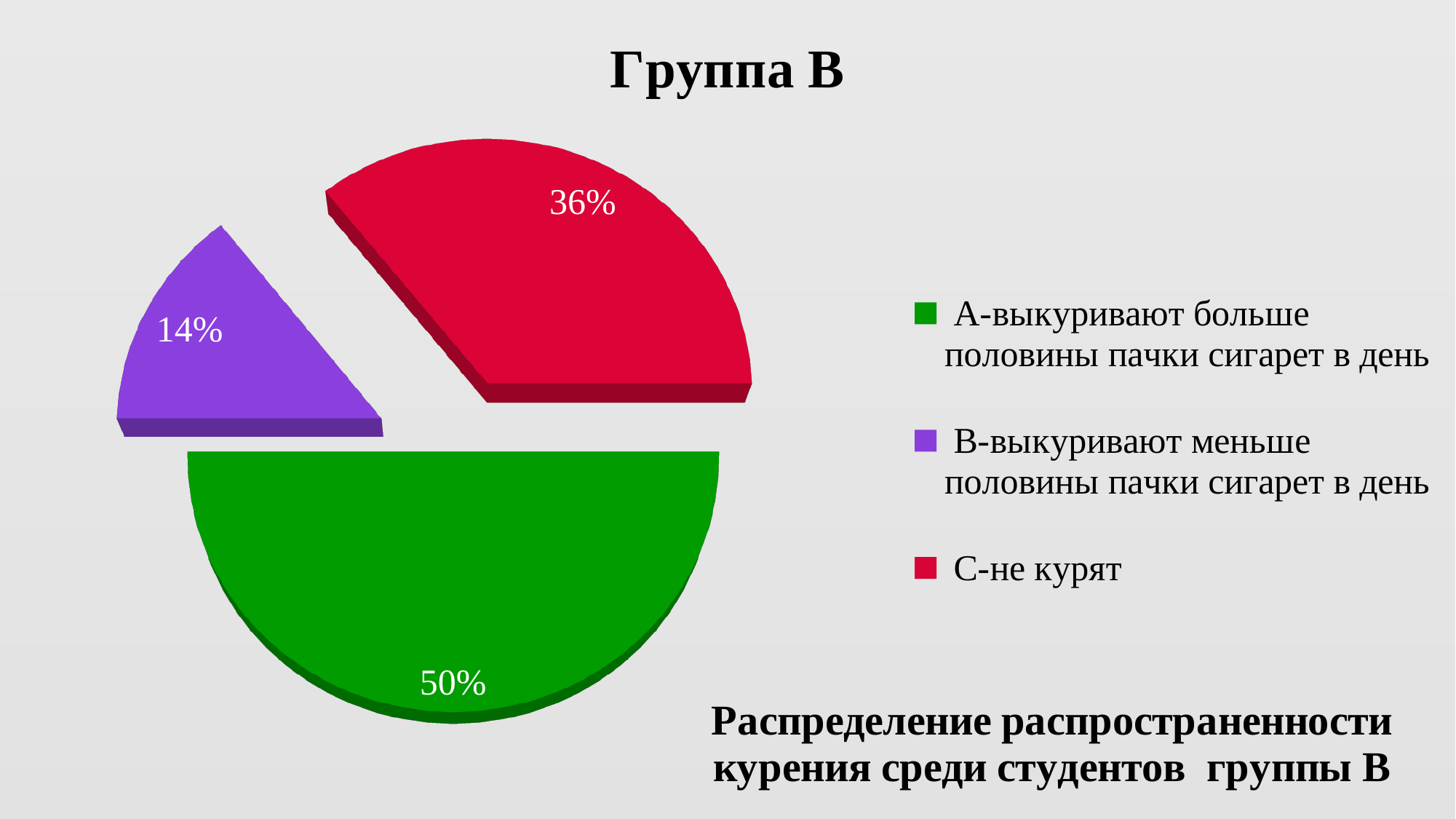
What share of the pie does the category "А-выкуривают больше половины пачки сигарет в день" represent? 50% Which category has the largest slice of the pie? А-выкуривают больше половины пачки сигарет в день What is the title of the chart? Группа В What share of the pie does the category "В-выкуривают меньше половины пачки сигарет в день" represent? 14% How many slices does the pie chart have? 3 What kind of chart is shown on the slide? Pie chart What share of the pie does the category "С-не курят" represent? 36% Which category has the smallest slice of the pie? В-выкуривают меньше половины пачки сигарет в день Which is larger: the share for "С-не курят" or the share for "В-выкуривают меньше половины пачки сигарет в день"? С-не курят What colour is the slice for "С-не курят"? Red What is the difference in percentage points between the "А-выкуривают больше половины пачки сигарет в день" slice and the "С-не курят" slice? 14 What is the difference in percentage points between the "С-не курят" slice and the "В-выкуривают меньше половины пачки сигарет в день" slice? 22